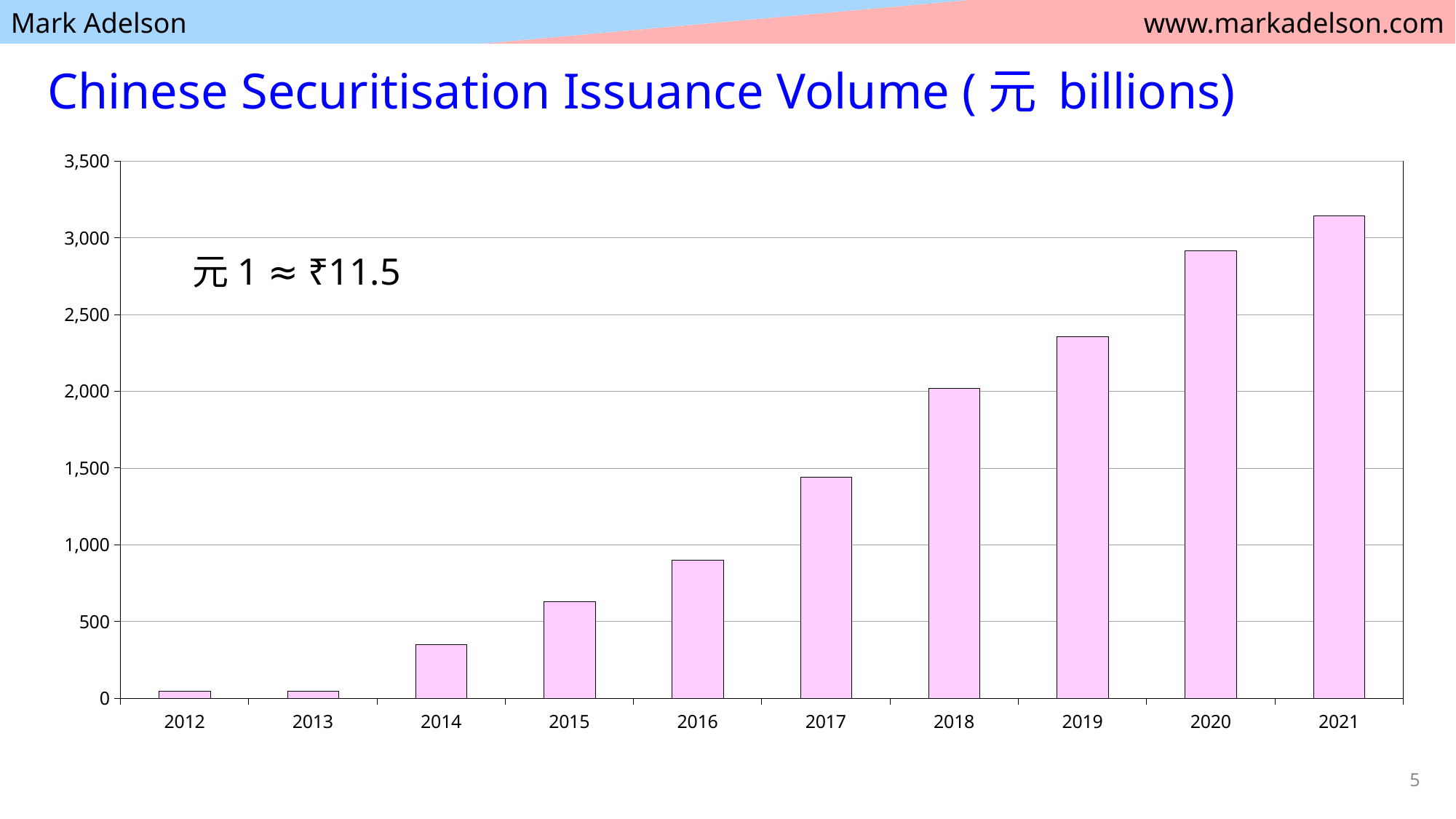
Do the values generally rise or fall from 2012 to 2021? rise Is the value for 2020 greater or less than 3,000? less Is the value for 2019 greater or less than 2,500? less Is the value for 2014 greater or less than 500? less What kind of chart is shown on the slide? bar chart How many years are shown on the x axis of the chart? 10 What is the title of the chart? Chinese Securitisation Issuance Volume (元 billions) Which is larger, the value for 2019 or the value for 2020? 2020 Which year has the highest issuance volume? 2021